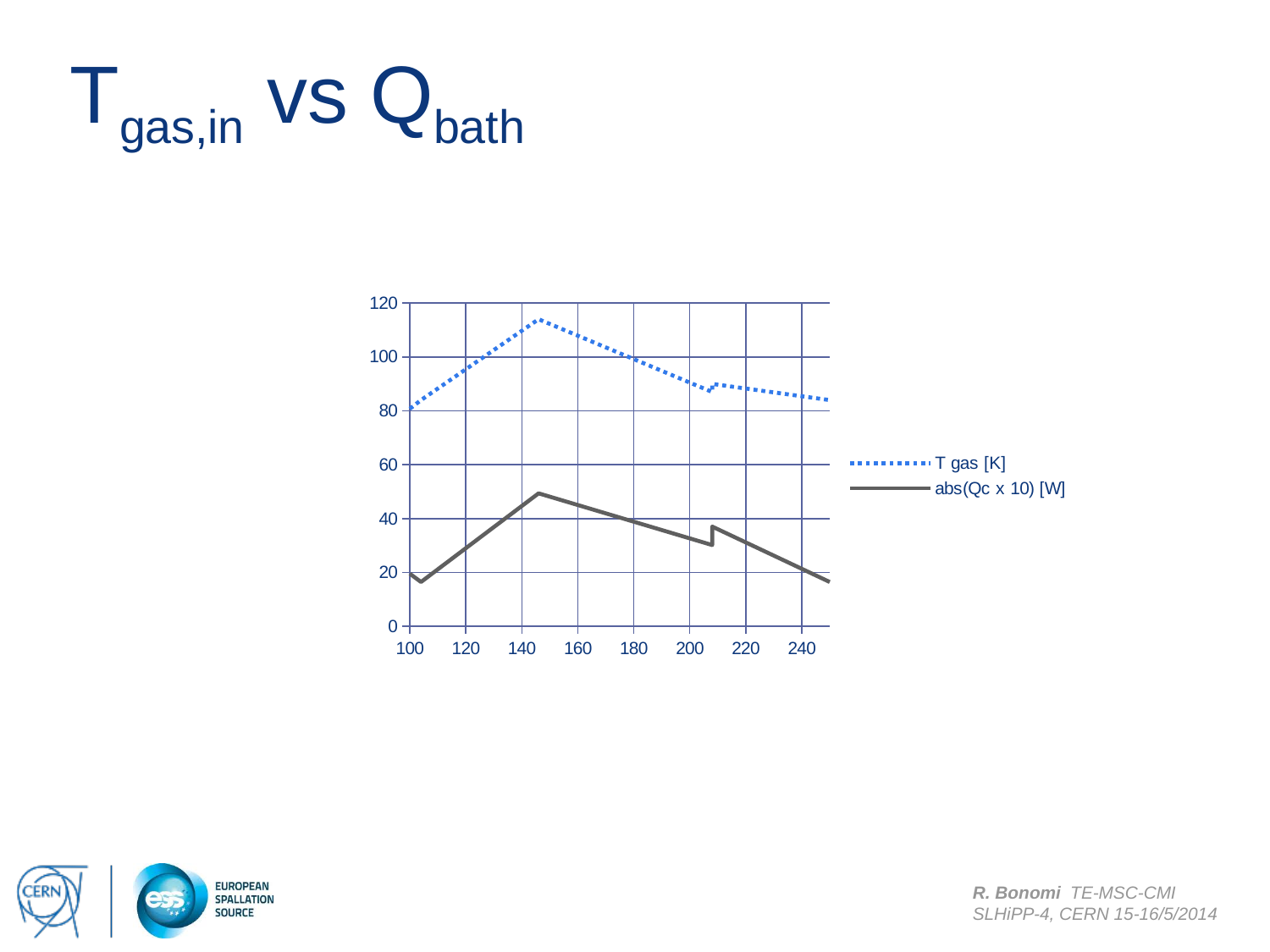
Is the peak value of abs(Qc x 10) [W] greater or less than 60? less Does T gas [K] rise or fall between x = 160 and x = 240? fall Is the peak value of T gas [K] greater or less than 100? greater Between which two x-axis ticks does T gas [K] reach its maximum? between 140 and 160 What kind of chart is shown on the slide? line chart Which series is drawn with a dotted line? T gas [K] Is the value of abs(Qc x 10) [W] at x = 100 greater or less than 40? less How many series does the legend list? 2 What are the two series named in the legend? T gas [K] and abs(Qc x 10) [W] At x = 200, which series has the higher value, T gas [K] or abs(Qc x 10) [W]? T gas [K] Does abs(Qc x 10) [W] rise or fall between x = 110 and x = 140? rise